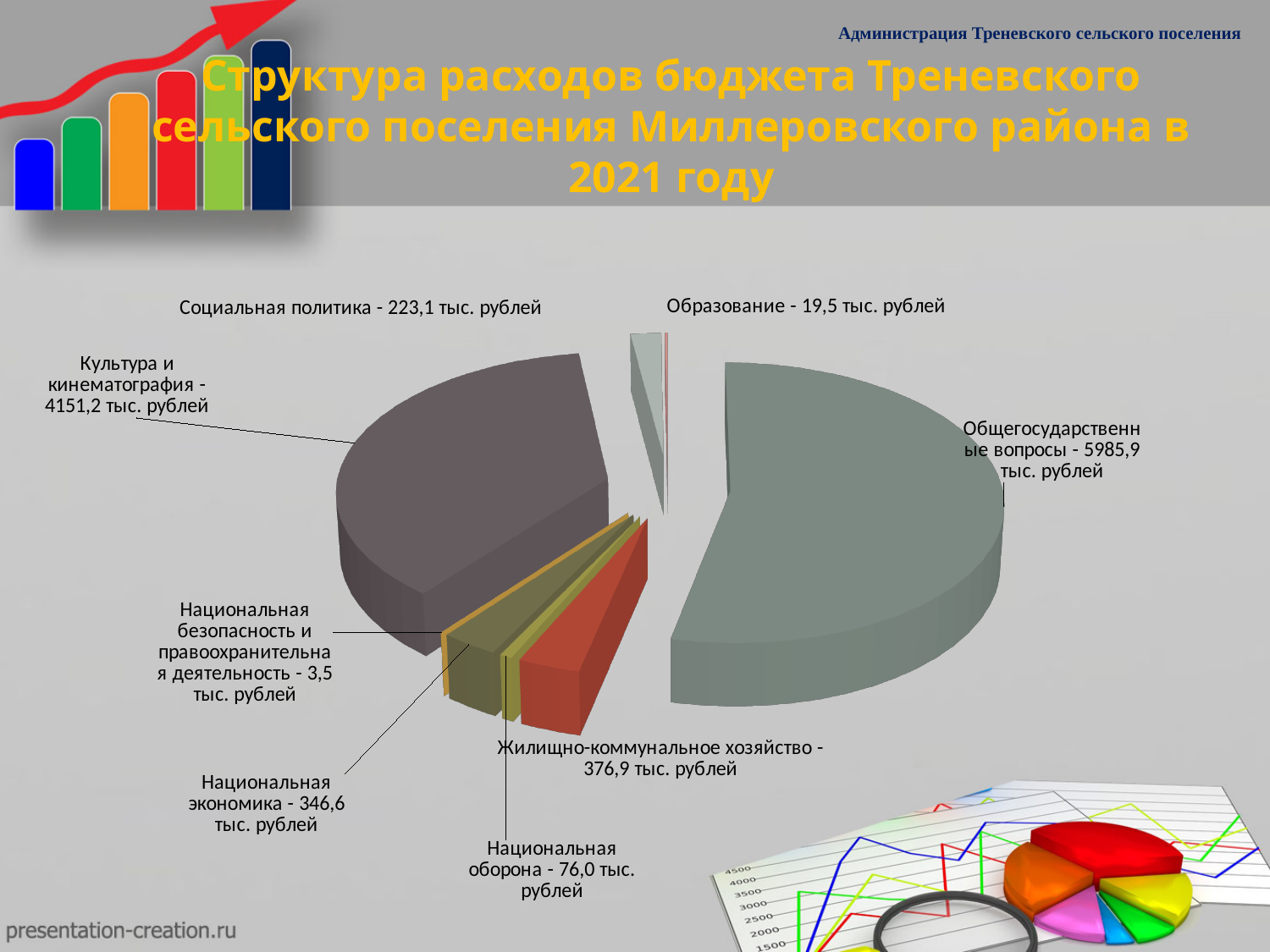
How many categories does the pie chart show? 8 Which category has the smallest expenditure? Национальная безопасность и правоохранительная деятельность What is the title of the slide containing the chart? Структура расходов бюджета Треневского сельского поселения Миллеровского района в 2021 году What is the value for Жилищно-коммунальное хозяйство? 376,9 тыс. рублей Which category has the largest expenditure? Общегосударственные вопросы What is the value for Культура и кинематография? 4151,2 тыс. рублей What kind of chart is shown on the slide? Pie chart What is the value for Национальная оборона? 76,0 тыс. рублей What is the value for Общегосударственные вопросы? 5985,9 тыс. рублей What is the difference between Общегосударственные вопросы and Культура и кинематография? 1834,7 тыс. рублей Which is larger: Жилищно-коммунальное хозяйство or Национальная экономика? Жилищно-коммунальное хозяйство What is the value for Образование? 19,5 тыс. рублей